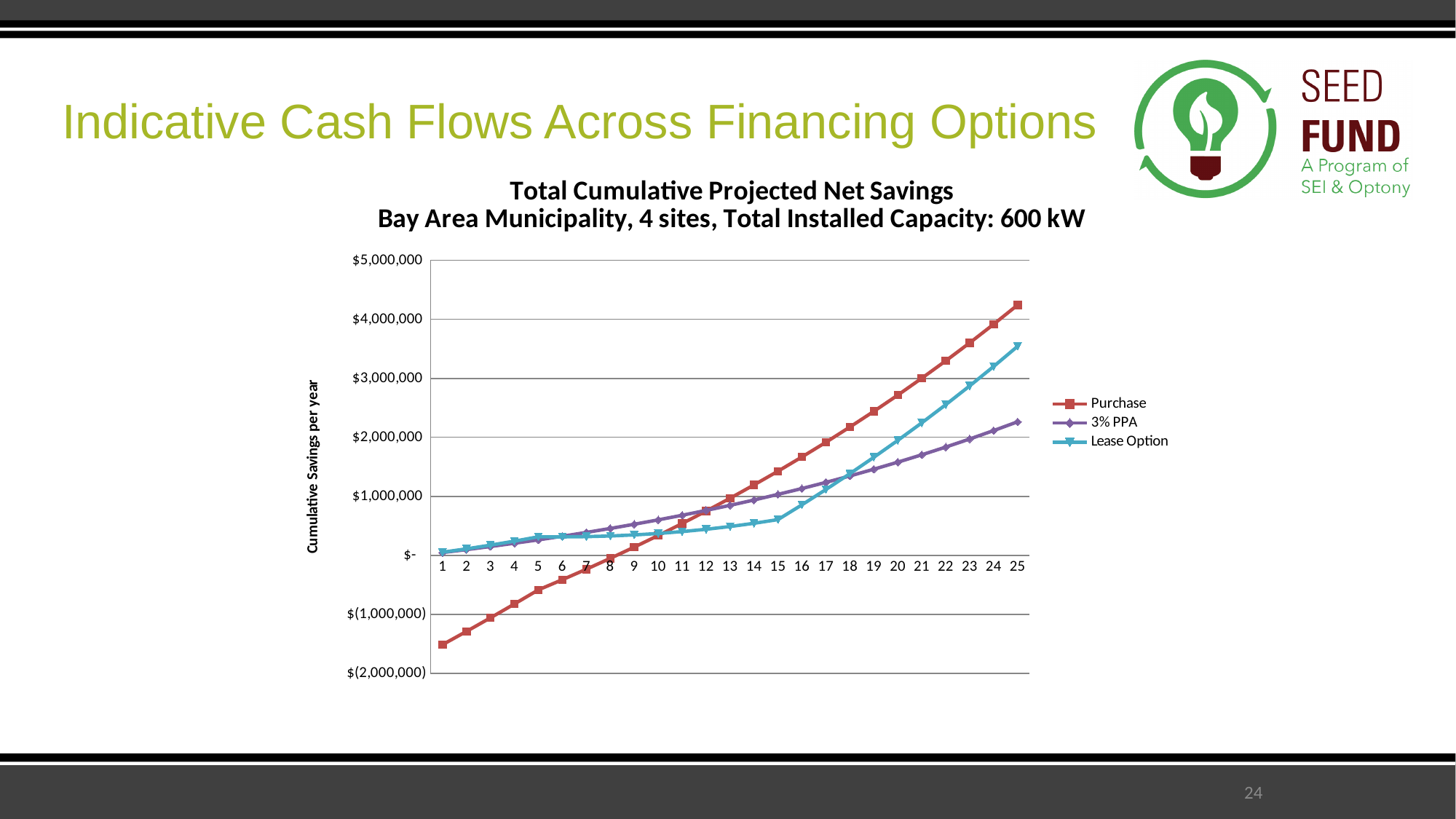
Is the value for Lease Option at year 25 greater or less than $4,000,000? less Is the value for Purchase at year 1 greater or less than $(1,000,000)? less Do the Purchase values rise or fall from year 1 to year 25? rise How many series does the legend list? 3 Which series has the lowest cumulative savings at year 1? Purchase What kind of chart is shown on the slide? line chart At year 20, which is larger: Lease Option or 3% PPA? Lease Option At year 5, which is larger: Purchase or 3% PPA? 3% PPA Which series has the lowest cumulative savings at year 25? 3% PPA How many years are shown along the x axis? 25 Is the value for Purchase at year 25 greater or less than $4,000,000? greater Which series has the highest cumulative savings at year 25? Purchase